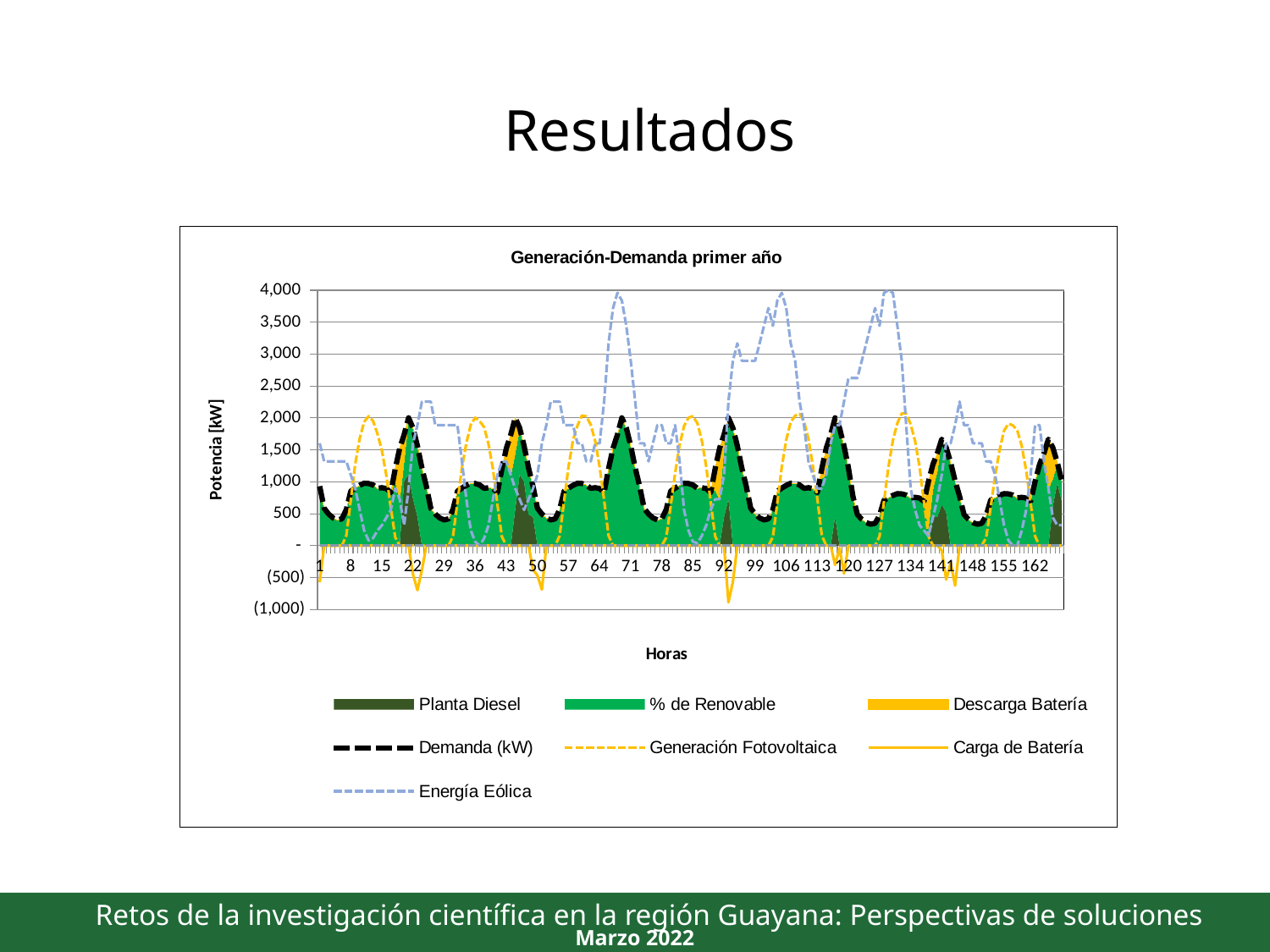
Is the highest value reached by Generación Fotovoltaica greater or less than 2,500? less Which series reaches the highest value on the chart? Energía Eólica What kind of chart is shown on the slide? line and area chart Is the highest value reached by Energía Eólica greater or less than 3,500? greater How many series does the chart's legend list? 7 What is the label of the vertical axis of the chart? Potencia [kW] Is the lowest value reached by Carga de Batería greater or less than (500)? less What is the title of the chart? Generación-Demanda primer año Which series reaches a higher peak value, Energía Eólica or Demanda (kW)? Energía Eólica Which series reaches a higher peak value, Generación Fotovoltaica or Energía Eólica? Energía Eólica